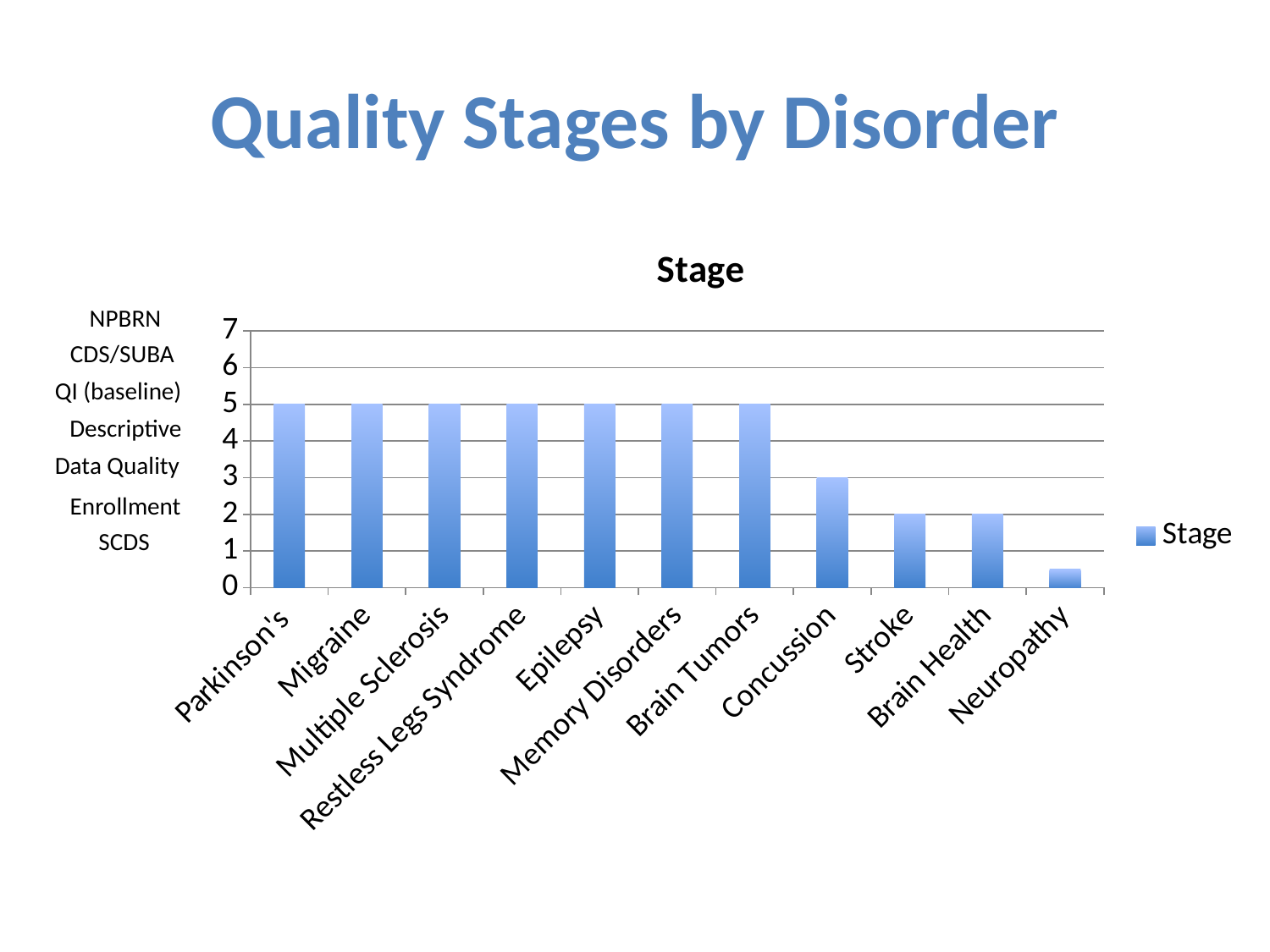
What is the difference between the stage values for Concussion and Stroke? 1 What is the stage value for Concussion? 3 What is the stage value for Parkinson's? 5 What is the stage value for Stroke? 2 Is the value for Neuropathy greater or less than 1? less How many series does the legend list? 1 Do the stage values rise or fall moving from left to right along the x axis? fall Which disorder has the lowest stage value? Neuropathy How many disorders are plotted on the x axis of the chart? 11 What type of chart is shown on the slide? bar chart Which has a larger stage value, Epilepsy or Brain Health? Epilepsy What is the title of the chart? Stage